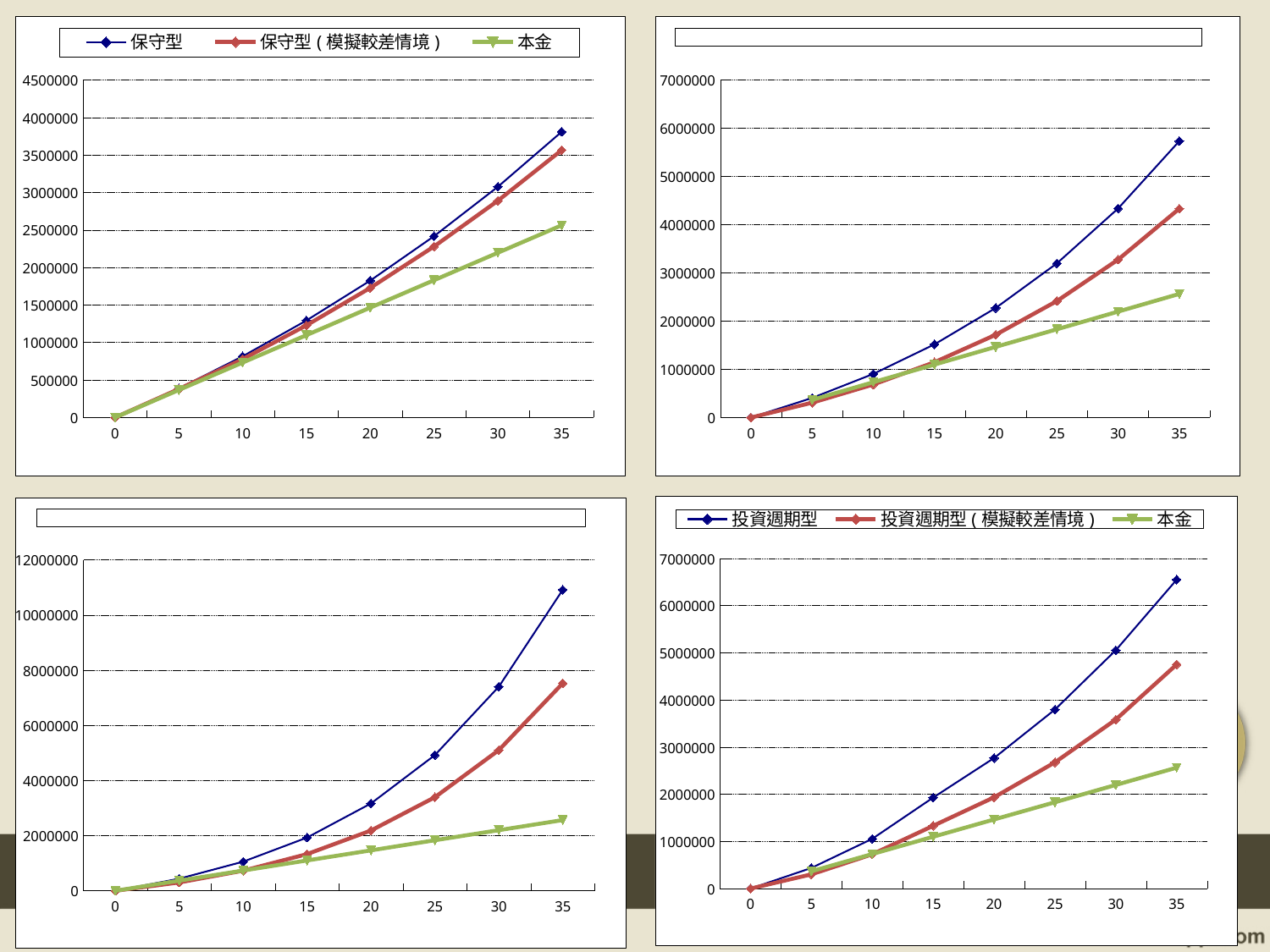
In the top-left chart, which series has the highest value at x = 35? 保守型 In the top-left chart, is the value of 保守型 at x = 35 greater or less than 3500000? greater In the bottom-left chart, is the value of the green series at x = 35 greater or less than 4000000? less What are the three legend entries of the bottom-right chart? 投資週期型, 投資週期型(模擬較差情境), 本金 In the bottom-left chart, is the value of the blue series at x = 35 greater or less than 10000000? greater In the bottom-right chart, which is larger at x = 35: 投資週期型 or 投資週期型(模擬較差情境)? 投資週期型 In the top-left chart, how many points are plotted along the x axis for each series? 8 What kind of chart is the top-left chart? line chart In the top-left chart, do the values of 保守型 rise or fall as x increases from 0 to 35? rise How many series does the legend of the top-left chart list? 3